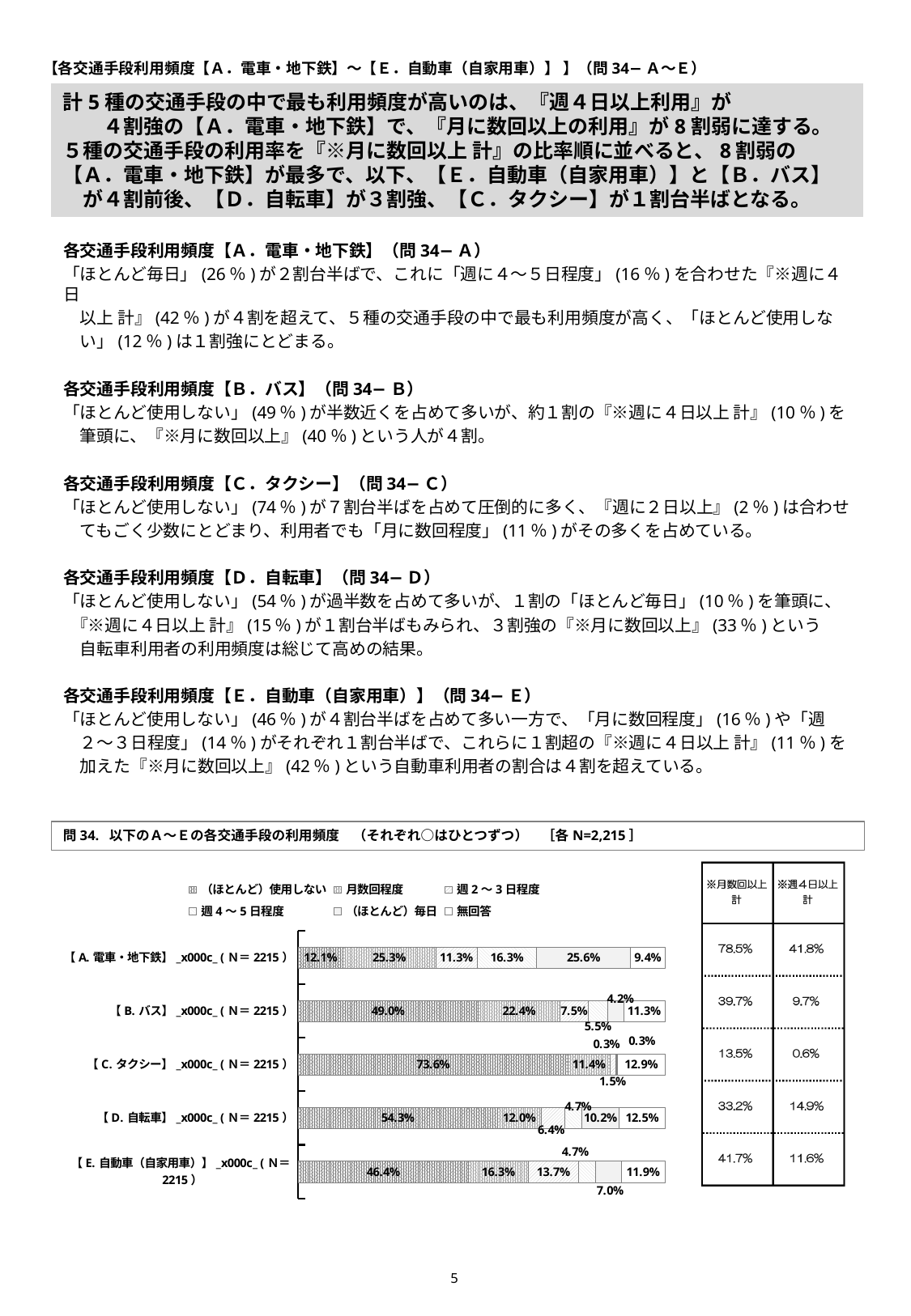
In the table to the right of the chart, what is the 「※月数回以上 計」 value for 【A. 電車・地下鉄】? 78.5% What is the value of 「（ほとんど）使用しない」 for 【C. タクシー】? 73.6% What is the value of 「（ほとんど）毎日」 for 【A. 電車・地下鉄】? 25.6% Which has the larger 「月数回程度」 value, 【A. 電車・地下鉄】 or 【B. バス】? A. 電車・地下鉄 Which transport mode has the highest 「（ほとんど）使用しない」 share? C. タクシー How many transport modes (categories) are plotted in the chart? 5 What kind of chart is used to show the usage frequency of transport modes A to E? bar chart What is the value of 「（ほとんど）使用しない」 for 【A. 電車・地下鉄】? 12.1% How many series does the chart legend list? 6 Which transport mode has the lowest 「（ほとんど）使用しない」 share? A. 電車・地下鉄 What is the difference between the 「（ほとんど）使用しない」 values for 【D. 自転車】 and 【E. 自動車（自家用車）】? 7.9 percentage points What is the 「無回答」 value for 【C. タクシー】? 12.9%